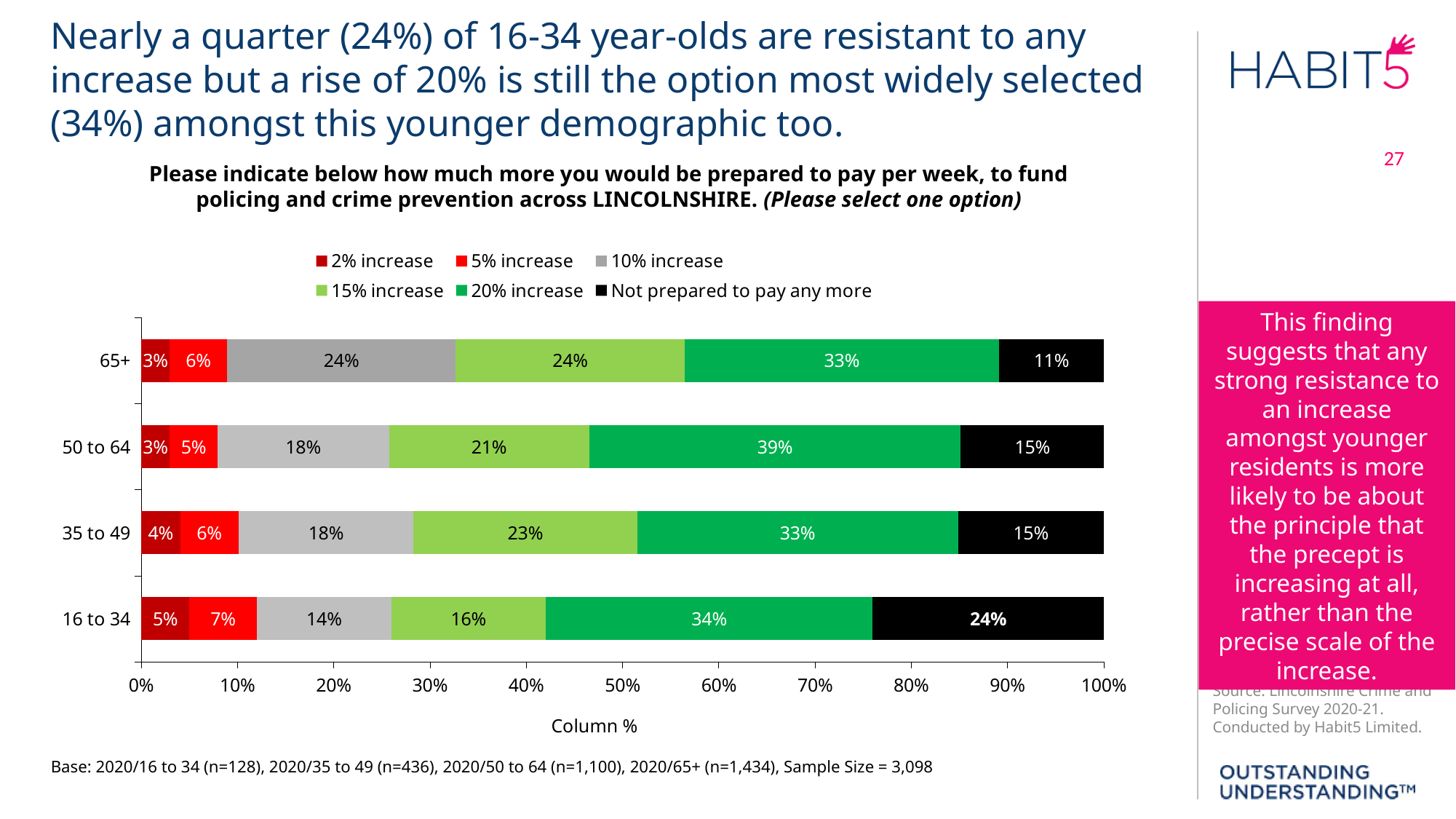
How many age groups are shown on the chart? 4 Which age group has the highest share selecting a 20% increase? 50 to 64 What percentage of 35 to 49 year-olds selected a 15% increase? 23% What is the difference between the 'Not prepared to pay any more' share for 16 to 34 and for 65+? 13 percentage points What is the value for the 10% increase segment in the 65+ age group? 24% What type of chart is shown on the slide? Stacked bar chart Which is larger: the 15% increase share for 65+ or for 16 to 34? 65+ How many series does the legend list? 6 What is the label on the horizontal axis of the chart? Column % Which age group has the lowest share selecting 'Not prepared to pay any more'? 65+ What percentage of 16 to 34 year-olds selected 'Not prepared to pay any more'? 24% What percentage of the 50 to 64 age group selected a 20% increase? 39%